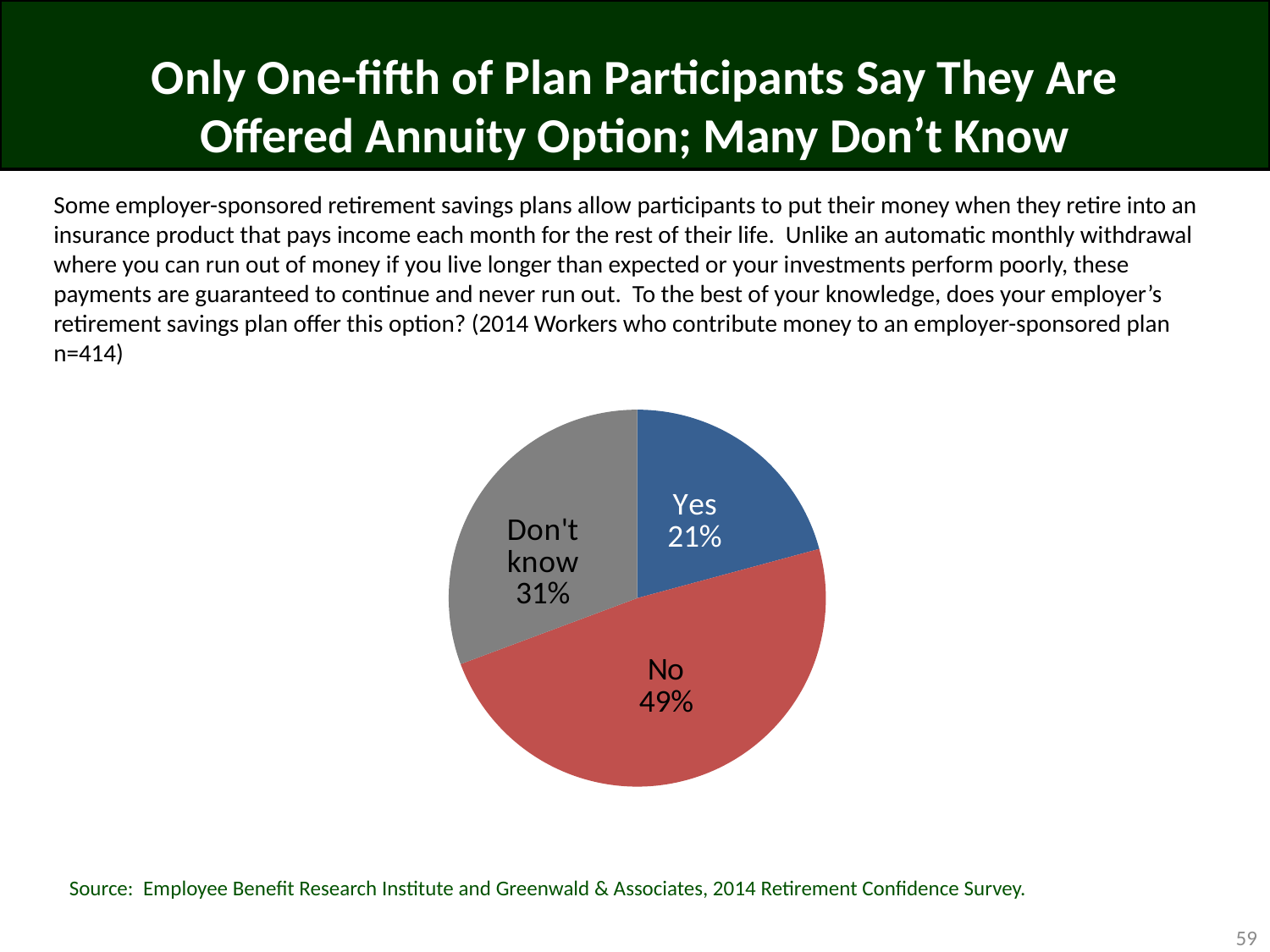
Which response has the largest share of the pie? No What is the difference in percentage points between the "Don't know" and "Yes" slices? 10 Which is larger, the "Don't know" slice or the "Yes" slice? Don't know What percentage of respondents answered "No"? 49% How many slices does the pie chart have? 3 What is the difference in percentage points between the "No" and "Yes" slices? 28 Which response has the smallest share of the pie? Yes What percentage of respondents answered "Yes"? 21% What percentage of respondents answered "Don't know"? 31% What kind of chart is shown on the slide? pie chart What colour is the "Don't know" slice? gray What colour is the "No" slice? red